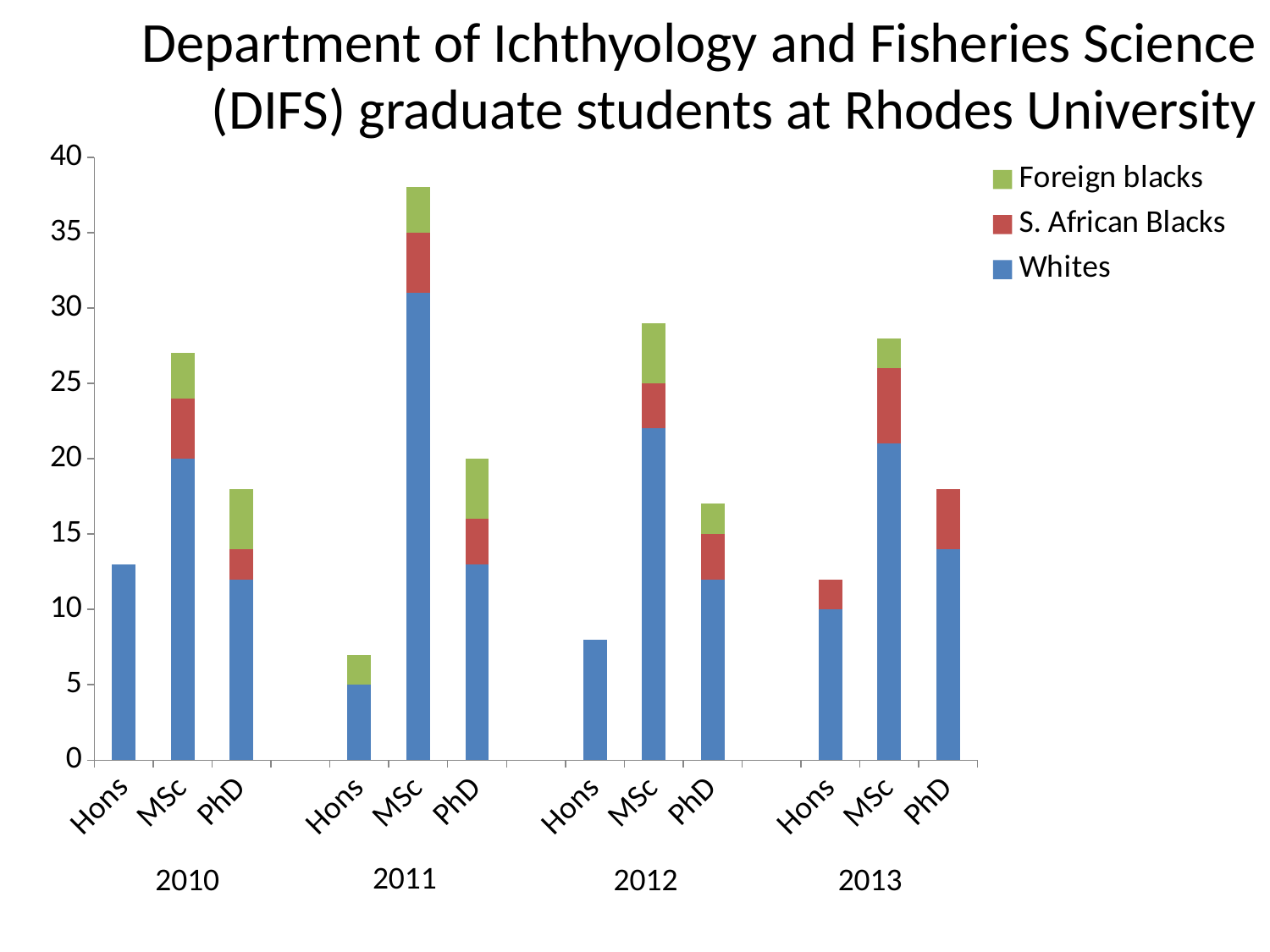
Is the total for MSc in 2012 greater or less than 25? greater Which bar has the lowest total number of graduate students? Hons in 2011 Is the total for MSc in 2011 greater or less than 35? greater Which is larger, the total for Hons in 2010 or the total for Hons in 2012? Hons in 2010 Which is larger, the total for MSc in 2011 or the total for MSc in 2012? MSc in 2011 Which bar has the highest total number of graduate students? MSc in 2011 Which colour represents the Whites series in the chart? Blue How many bars are plotted in the chart? 12 Is the total for Hons in 2010 greater or less than 15? less What kind of chart is shown on the slide? Stacked bar chart How many series does the legend list? 3